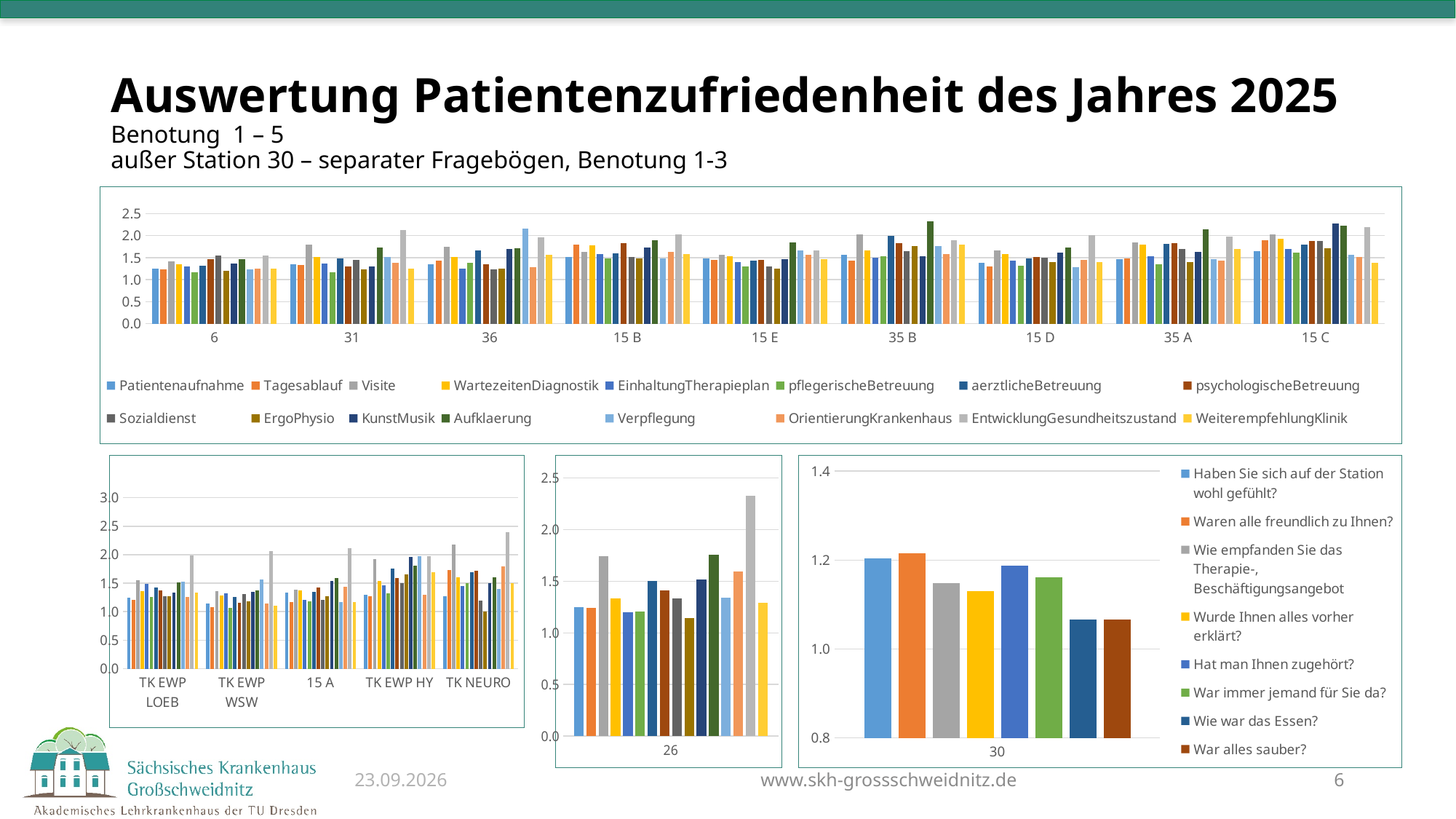
In the bottom-right chart for station 30, is the value for 'Wie war das Essen?' greater or less than 1.2? less In the bottom-left chart, how many categories are shown along the x axis? 5 In the bottom-right chart for station 30, which legend entry is listed first? Haben Sie sich auf der Station wohl gefühlt? In the bottom-left chart, is the EntwicklungGesundheitszustand value for TK NEURO greater or less than 2.0? greater In the bottom-right chart for station 30, how many series does the legend list? 8 In the large chart at the top of the slide, how many series does the legend list? 16 What kind of chart is the large chart at the top of the slide? bar chart In the large chart at the top of the slide, is the Aufklaerung value for station 35 B greater or less than 2.0? greater In the large chart at the top of the slide, how many stations are shown along the x axis? 9